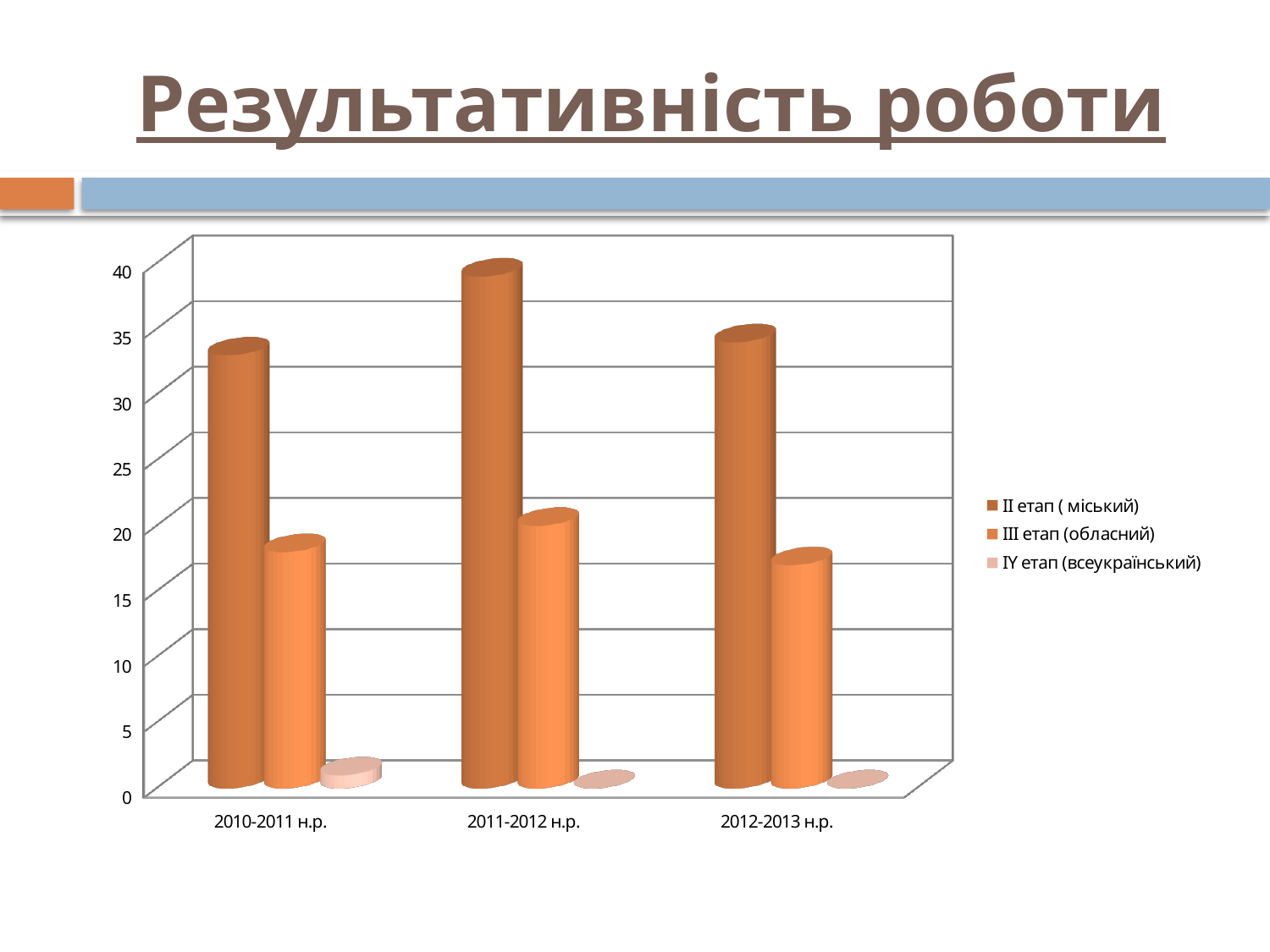
Is the value for II етап ( міський) in 2011-2012 н.р. greater or less than 35? greater Which is larger in 2012-2013 н.р.: II етап ( міський) or III етап (обласний)? II етап ( міський) How many series does the legend list? 3 Is the value for III етап (обласний) in 2010-2011 н.р. greater or less than 15? greater Is the value for II етап ( міський) in 2010-2011 н.р. greater or less than 30? greater What kind of chart is shown on the slide? bar chart Which series has the lowest values in every category? IY етап (всеукраїнський) In which category is the value for II етап ( міський) highest? 2011-2012 н.р. In which category is the value for III етап (обласний) highest? 2011-2012 н.р. What is the title of the slide containing the chart? Результативність роботи How many categories are shown on the x axis? 3